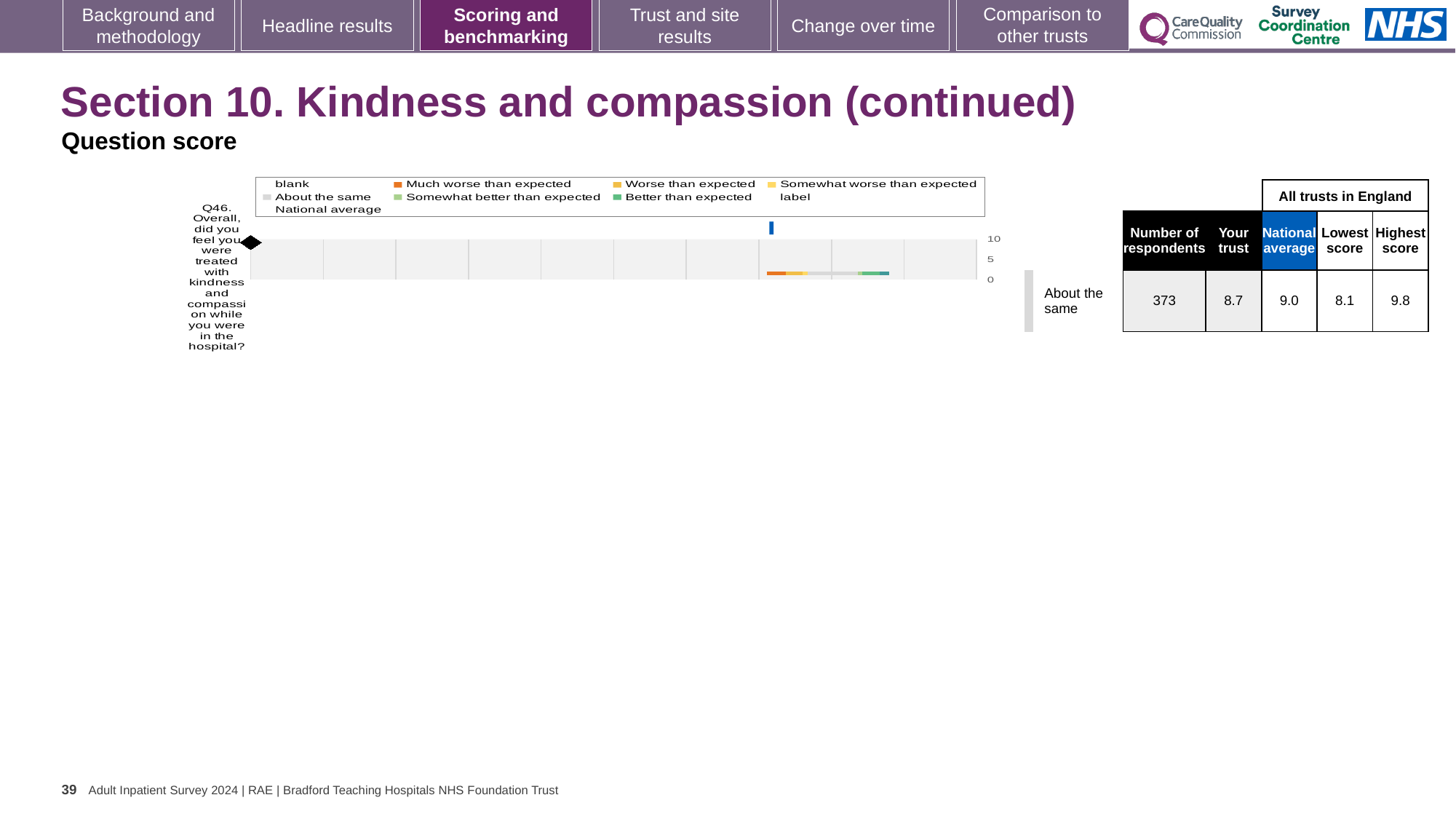
What kind of chart is shown on the slide? bar chart What is the national average score for Q46? 9.0 What is the highest value shown on the chart's score axis? 10 Which question is plotted in the chart? Q46. Overall, did you feel you were treated with kindness and compassion while you were in the hospital? What is the highest score among all trusts in England for Q46? 9.8 What is the lowest score among all trusts in England for Q46? 8.1 What is the difference between the national average and the trust's score for Q46? 0.3 How many questions (categories) are plotted in the chart? 1 Which is larger for Q46, the trust's score or the national average? national average What is the trust's score for Q46? 8.7 What does the blue marker in the chart legend represent? National average How many respondents answered Q46? 373